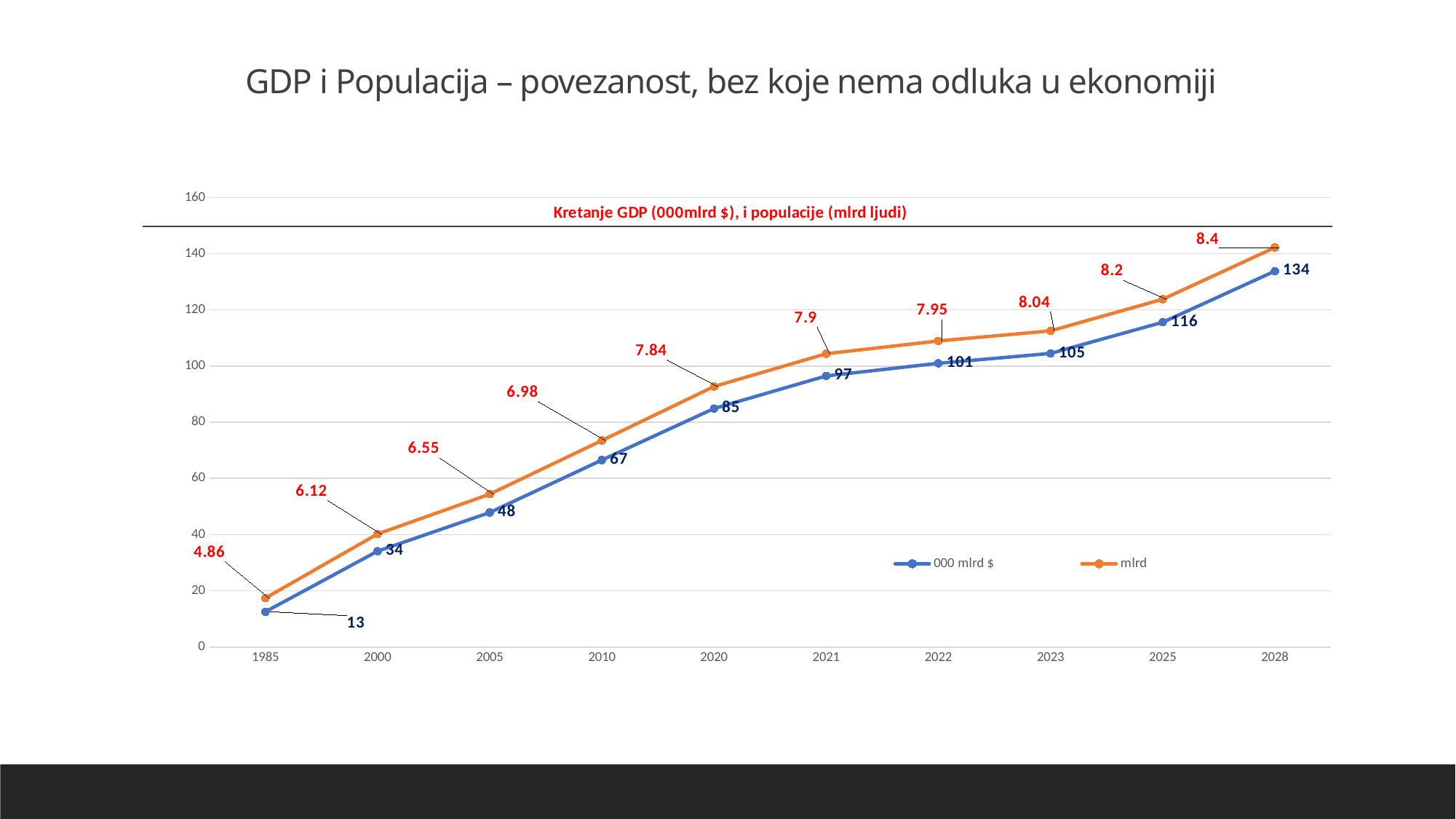
What is the difference between the "000 mlrd $" values for 2028 and 2025? 18 How many years are shown on the x axis? 10 How many series does the legend list? 2 Which year has a larger "000 mlrd $" value, 2005 or 2020? 2020 Do the values of the "000 mlrd $" series rise or fall from 1985 to 2028? Rise What is the value of the "mlrd" series for 2020? 7.84 What kind of chart is shown on the slide? Line chart What is the value of the "000 mlrd $" series for 2010? 67 In which year is the "mlrd" series at its lowest value? 1985 What is the value of the "mlrd" series for 2028? 8.4 What is the value of the "000 mlrd $" series for 1985? 13 In which year does the "000 mlrd $" series reach its highest value? 2028